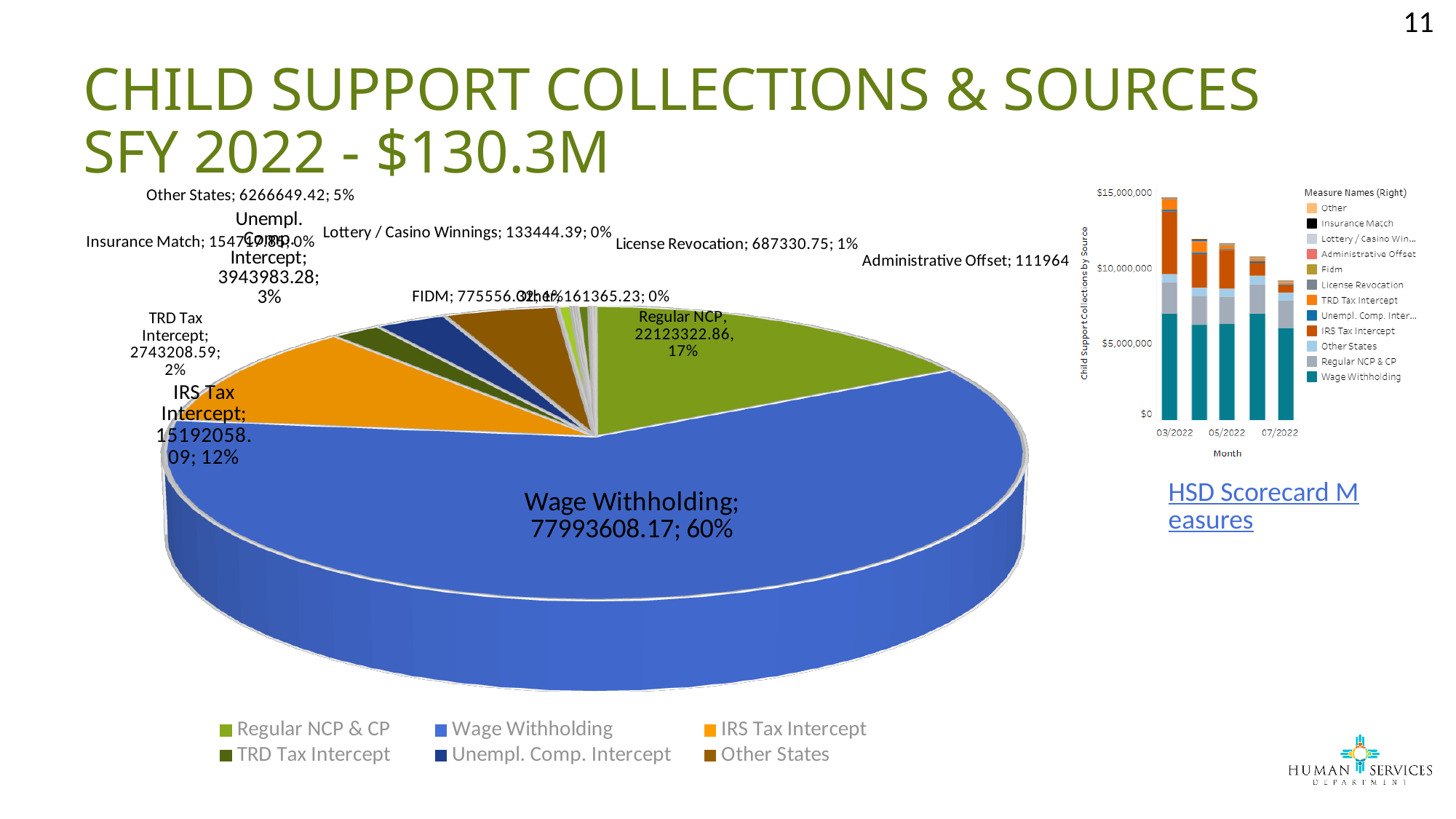
In the pie chart, what percentage is shown for Regular NCP? 17% What kind of chart is the large chart on the left of the slide? Pie chart In the pie chart, which source has the largest slice? Wage Withholding What kind of chart is the small chart on the right of the slide? Bar chart In the pie chart, which is larger: IRS Tax Intercept or TRD Tax Intercept? IRS Tax Intercept How many entries does the legend below the pie chart list? 6 In the small bar chart on the right, is the total for 03/2022 greater or less than $10,000,000? greater In the pie chart, what is the value shown for IRS Tax Intercept? 15192058.09 In the pie chart, what is the difference between the Wage Withholding value and the Regular NCP value? 55870285.31 In the pie chart, what share of collections comes from Wage Withholding? 60% In the pie chart, what is the value shown for Other States? 6266649.42 In the pie chart, what percentage is shown for Unempl. Comp. Intercept? 3%